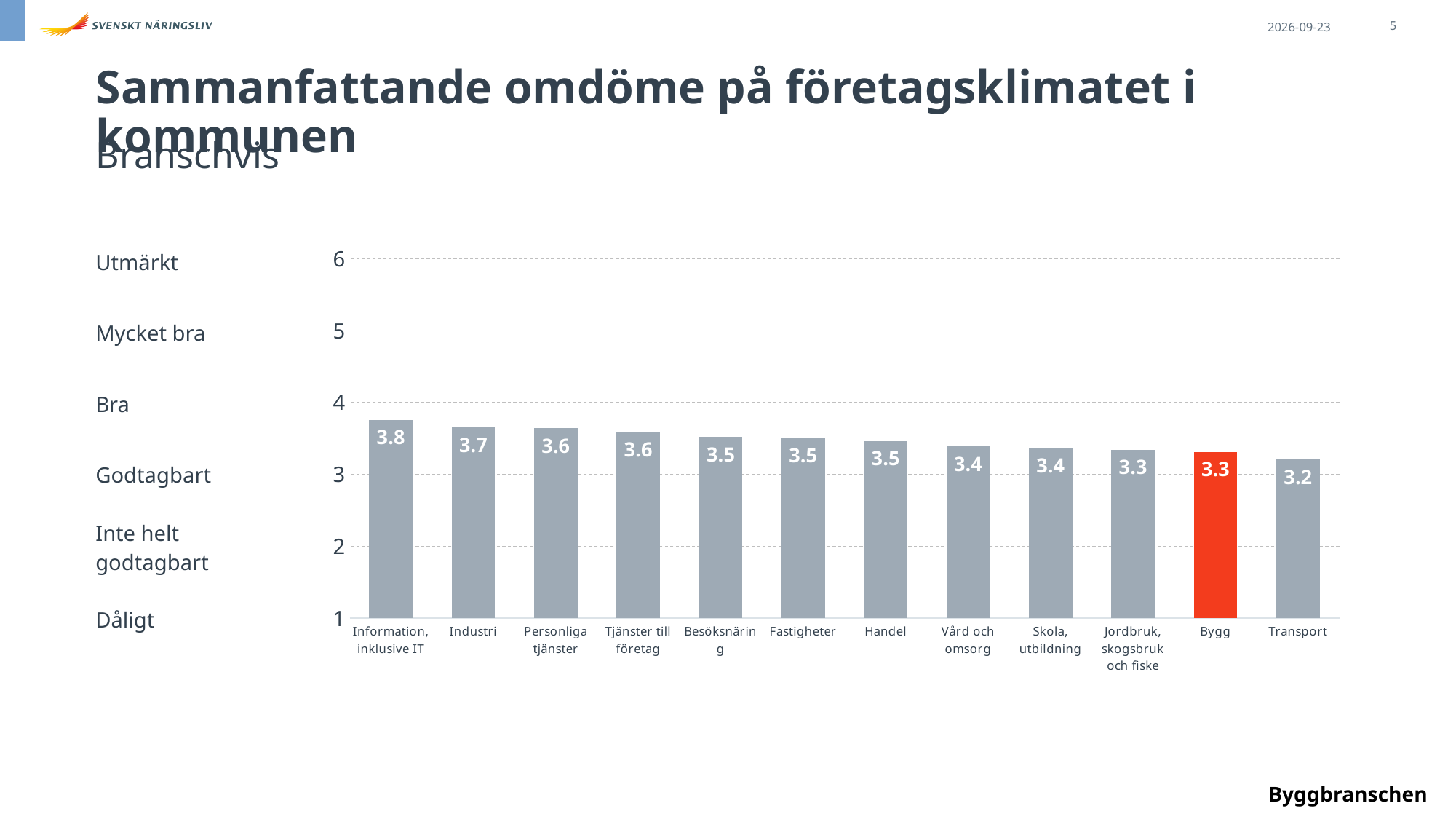
Which category has the highest value? Information, inklusive IT What is the value for Transport? 3.2 What is the difference between the values for Information, inklusive IT and Transport? 0.6 How many categories are shown on the x axis? 12 Which bar is highlighted in red? Bygg What is the value for Handel? 3.5 What kind of chart is shown on the slide? bar chart Which category has the lowest value? Transport Which is larger, the value for Industri or the value for Bygg? Industri What is the value for Bygg? 3.3 Is the value for Bygg greater or less than 4? less What is the value for Information, inklusive IT? 3.8